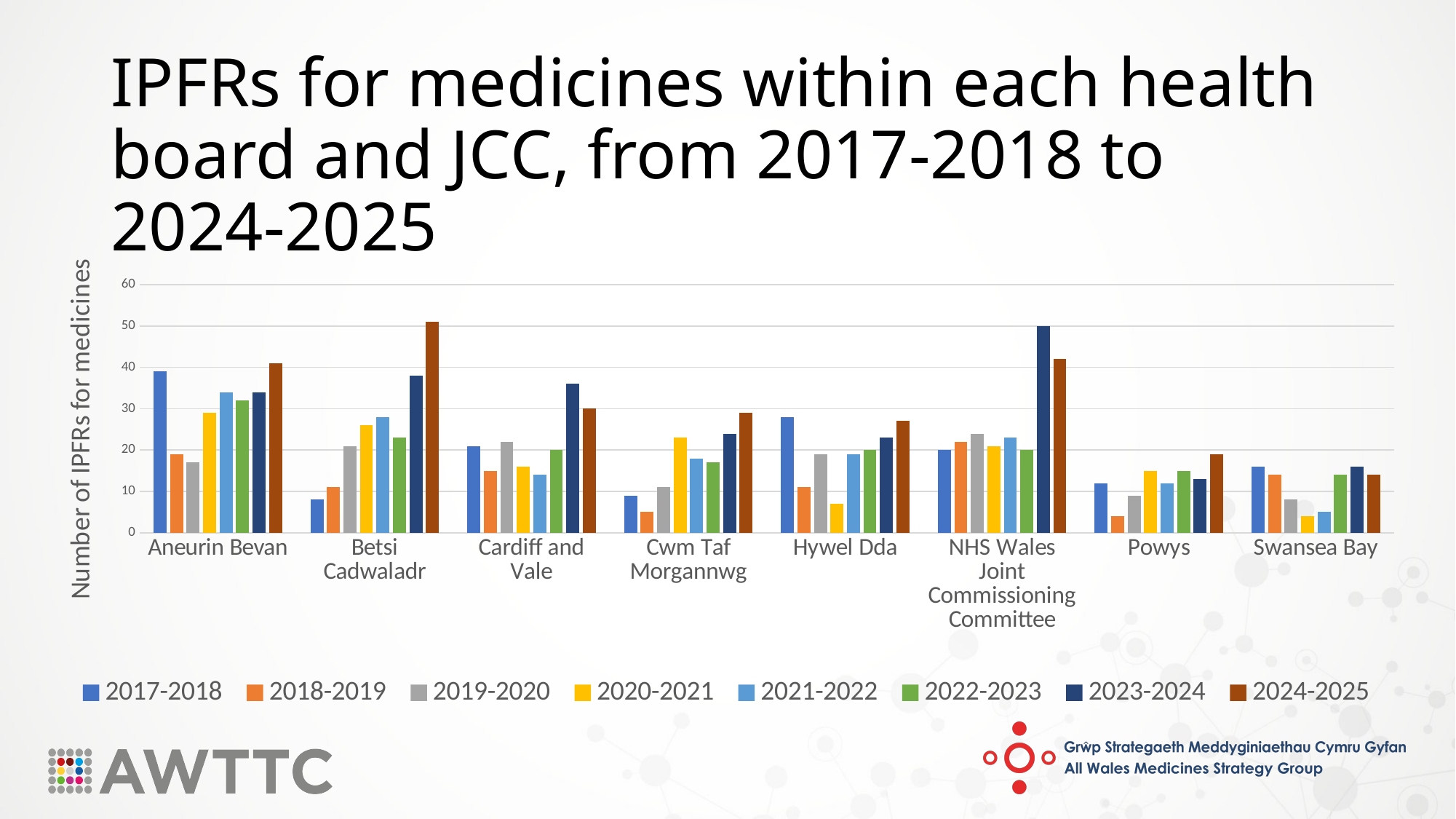
What is the label on the vertical axis? Number of IPFRs for medicines Is the value for Cwm Taf Morgannwg in 2018-2019 greater or less than 10? less Is the value for Betsi Cadwaladr in 2024-2025 greater or less than 40? greater For Cwm Taf Morgannwg, which year has the lowest number of IPFRs? 2018-2019 How many health boards/committees are shown along the x axis? 8 For Hywel Dda, which year has the lowest number of IPFRs? 2020-2021 For Betsi Cadwaladr, which year has the highest number of IPFRs? 2024-2025 Is the value for Aneurin Bevan in 2017-2018 greater or less than 30? greater For Hywel Dda, do the values rise or fall from 2020-2021 to 2024-2025? rise What kind of chart is shown on the slide? bar chart For Cardiff and Vale, which is larger: the value for 2023-2024 or 2024-2025? 2023-2024 How many series does the legend list? 8